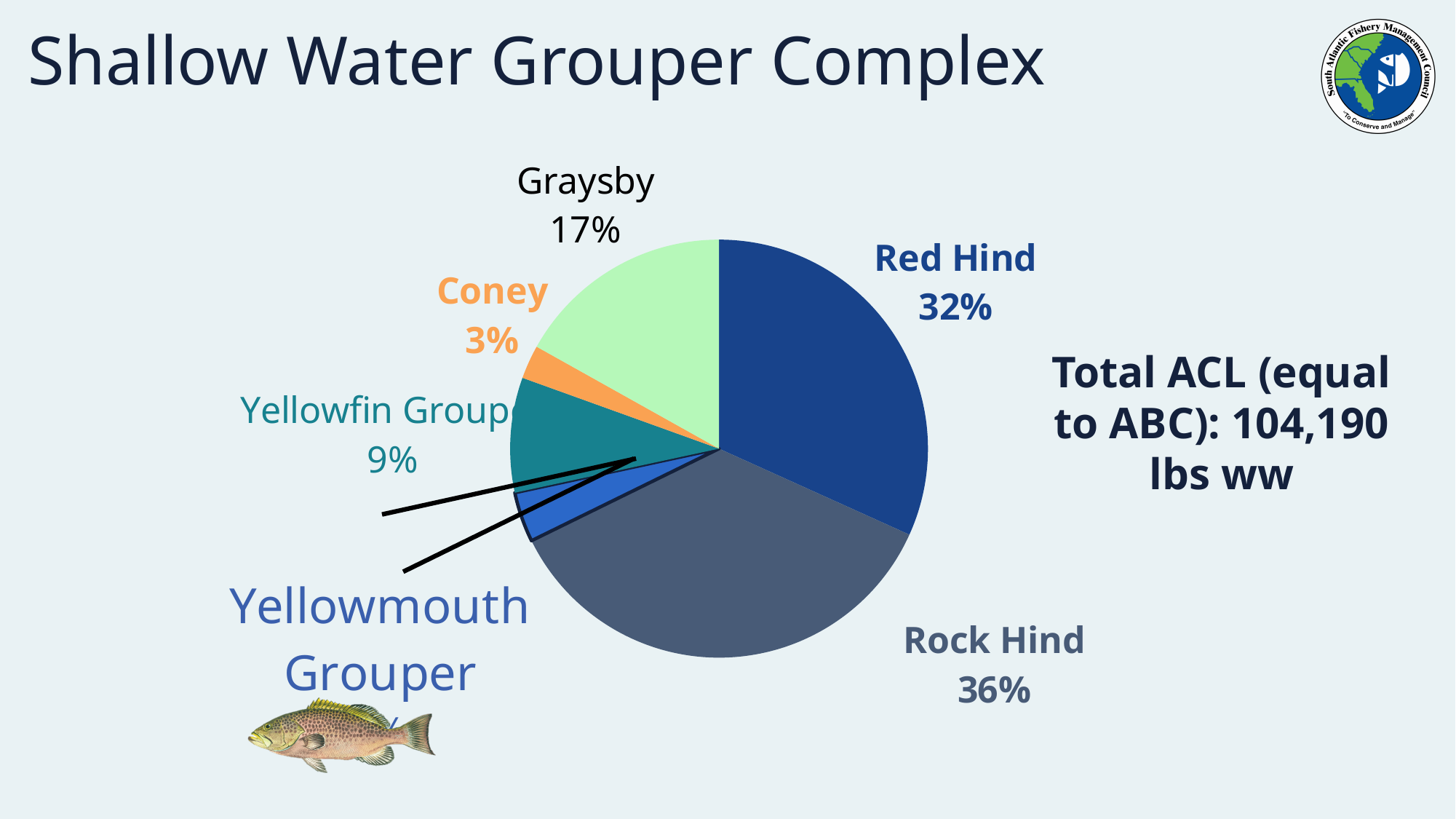
What is the Total ACL (equal to ABC) stated next to the chart? 104,190 lbs ww What share of the pie is Coney? 3% What share of the pie is Graysby? 17% What is the combined share of Red Hind and Rock Hind? 68% How many percentage points larger is Graysby's share than Yellowfin Grouper's share? 8 What kind of chart is shown on the slide? Pie chart What percentage of the pie does Rock Hind account for? 36% Which has the larger share, Graysby or Yellowfin Grouper? Graysby What percentage is shown for Yellowfin Grouper? 9% How many percentage points larger is Rock Hind's share than Red Hind's share? 4 Which species has the largest slice of the pie? Rock Hind What percentage of the pie does Red Hind account for? 32%